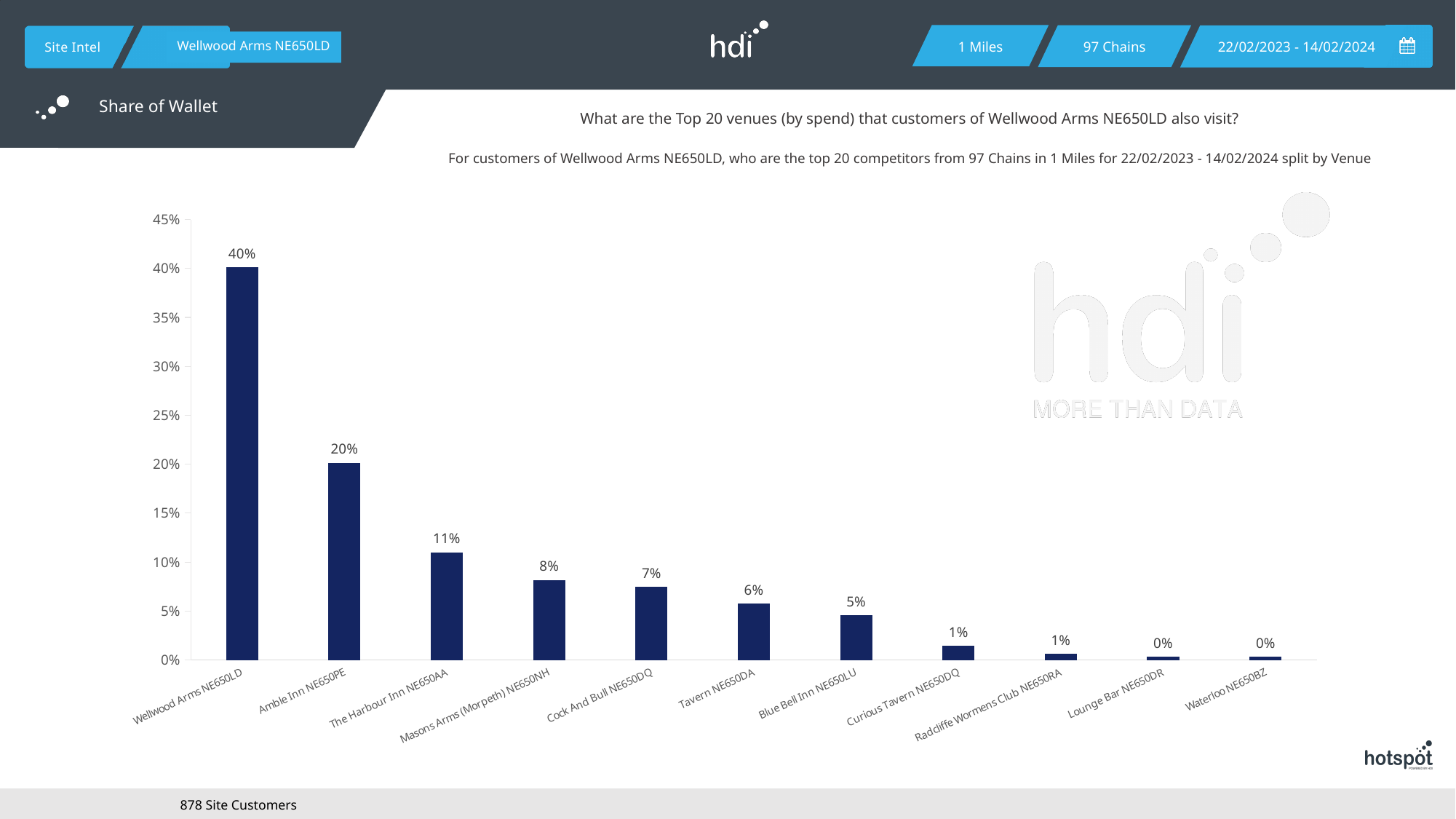
Which venue has the highest value? Wellwood Arms NE650LD What is the value for Cock And Bull NE650DQ? 7% Which is larger, the value for Masons Arms (Morpeth) NE650NH or the value for Tavern NE650DA? Masons Arms (Morpeth) NE650NH Is the value for The Harbour Inn NE650AA greater or less than 10%? greater What is the value for Blue Bell Inn NE650LU? 5% What kind of chart is shown on the slide? Bar chart What is the value for Wellwood Arms NE650LD? 40% What is the difference between the values for Wellwood Arms NE650LD and Amble Inn NE650PE? 20% What is the value for Amble Inn NE650PE? 20% Do the values rise or fall from left to right along the x axis? Fall What is the value for The Harbour Inn NE650AA? 11% How many venues are shown on the chart? 11